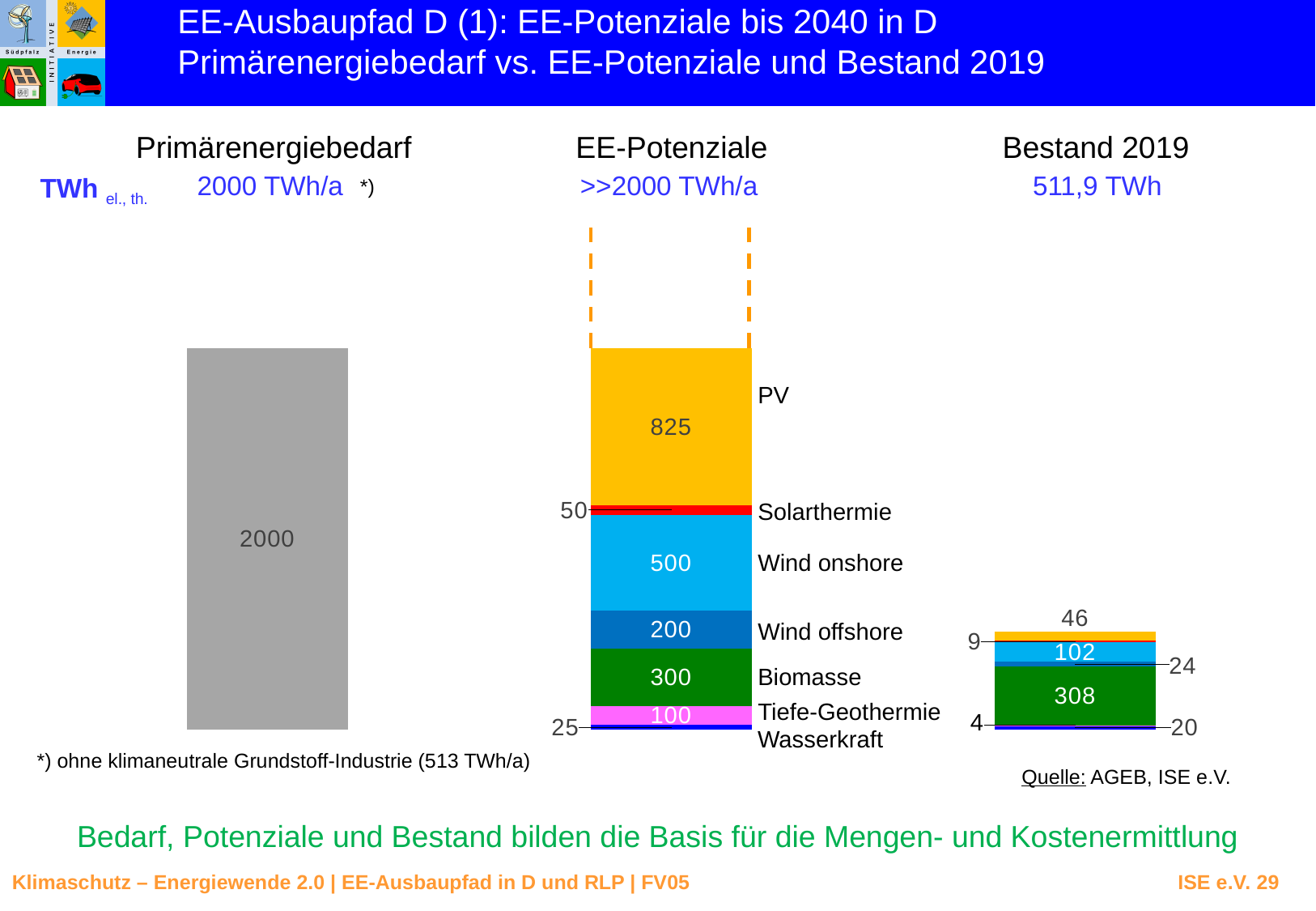
In the EE-Potenziale chart, which is larger, Biomasse or Wind offshore? Biomasse In the EE-Potenziale chart, what is the value for Wind onshore? 500 In the Primärenergiebedarf chart, what value is printed on the gray bar? 2000 In the EE-Potenziale chart, what is the difference between Wind onshore and Wind offshore? 300 In the EE-Potenziale chart, which category has the smallest segment? Wasserkraft In the EE-Potenziale chart, what is the value for Wasserkraft? 25 In the EE-Potenziale chart, what is the value for Biomasse? 300 What kind of chart is used for EE-Potenziale? Stacked bar chart In the EE-Potenziale chart, what is the value of the PV segment? 825 In the Bestand 2019 chart, what value is printed on the green Biomasse segment? 308 In the EE-Potenziale chart, which category has the largest segment? PV How many segments make up the EE-Potenziale stacked bar? 7